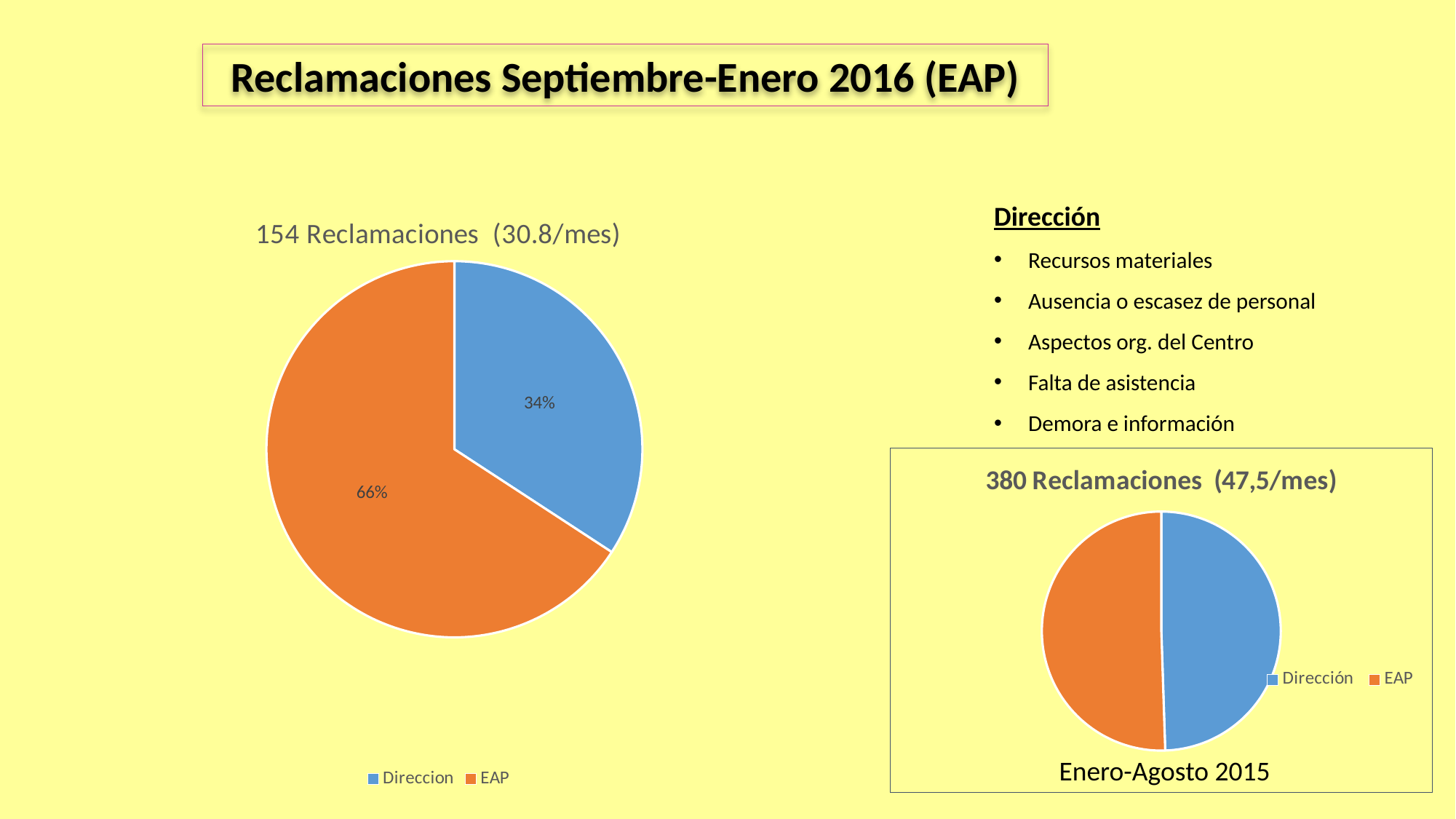
In the chart titled "154 Reclamaciones (30.8/mes)", what is the difference in percentage points between the EAP and Direccion slices? 32 In the chart titled "154 Reclamaciones (30.8/mes)", which category has the smallest slice? Direccion What period label appears below the chart titled "380 Reclamaciones (47,5/mes)"? Enero-Agosto 2015 In the chart titled "154 Reclamaciones (30.8/mes)", what colour is the EAP slice? Orange How many slices does the chart titled "154 Reclamaciones (30.8/mes)" have? 2 In the chart titled "154 Reclamaciones (30.8/mes)", what share of the pie is EAP? 66% What kind of chart is the one titled "380 Reclamaciones (47,5/mes)"? Pie chart How many entries does the legend of the chart titled "380 Reclamaciones (47,5/mes)" list? 2 In the chart titled "154 Reclamaciones (30.8/mes)", which category has the largest slice? EAP What kind of chart is the one titled "154 Reclamaciones (30.8/mes)"? Pie chart In the chart titled "154 Reclamaciones (30.8/mes)", which is larger, the Direccion slice or the EAP slice? EAP In the chart titled "154 Reclamaciones (30.8/mes)", what share of the pie is Direccion? 34%